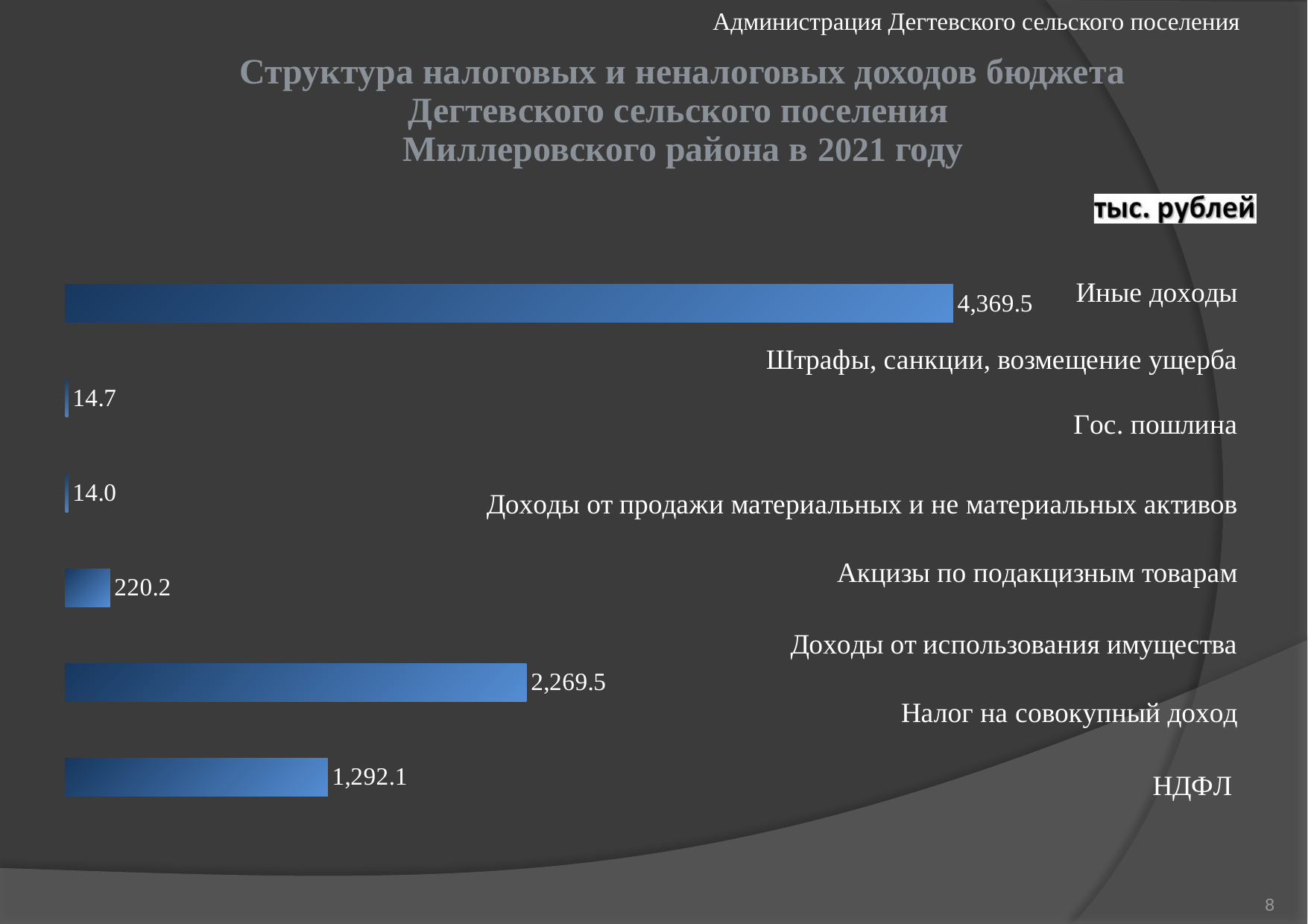
What is the value for Иные доходы? 4,369.5 What is the difference between the values for Иные доходы and НДФЛ? 3,077.4 In what units are the values on the chart given? тыс. рублей What kind of chart is shown on the slide? bar chart What is the value for НДФЛ? 1,292.1 How many bars are plotted on the chart? 6 Which category has the highest value? Иные доходы What is the smallest value printed on the chart? 14.0 Which is larger, the value for Иные доходы or the value for НДФЛ? Иные доходы What year does the chart title refer to? 2021 What is the difference between the largest value (4,369.5) and the second-largest value (2,269.5)? 2,100.0